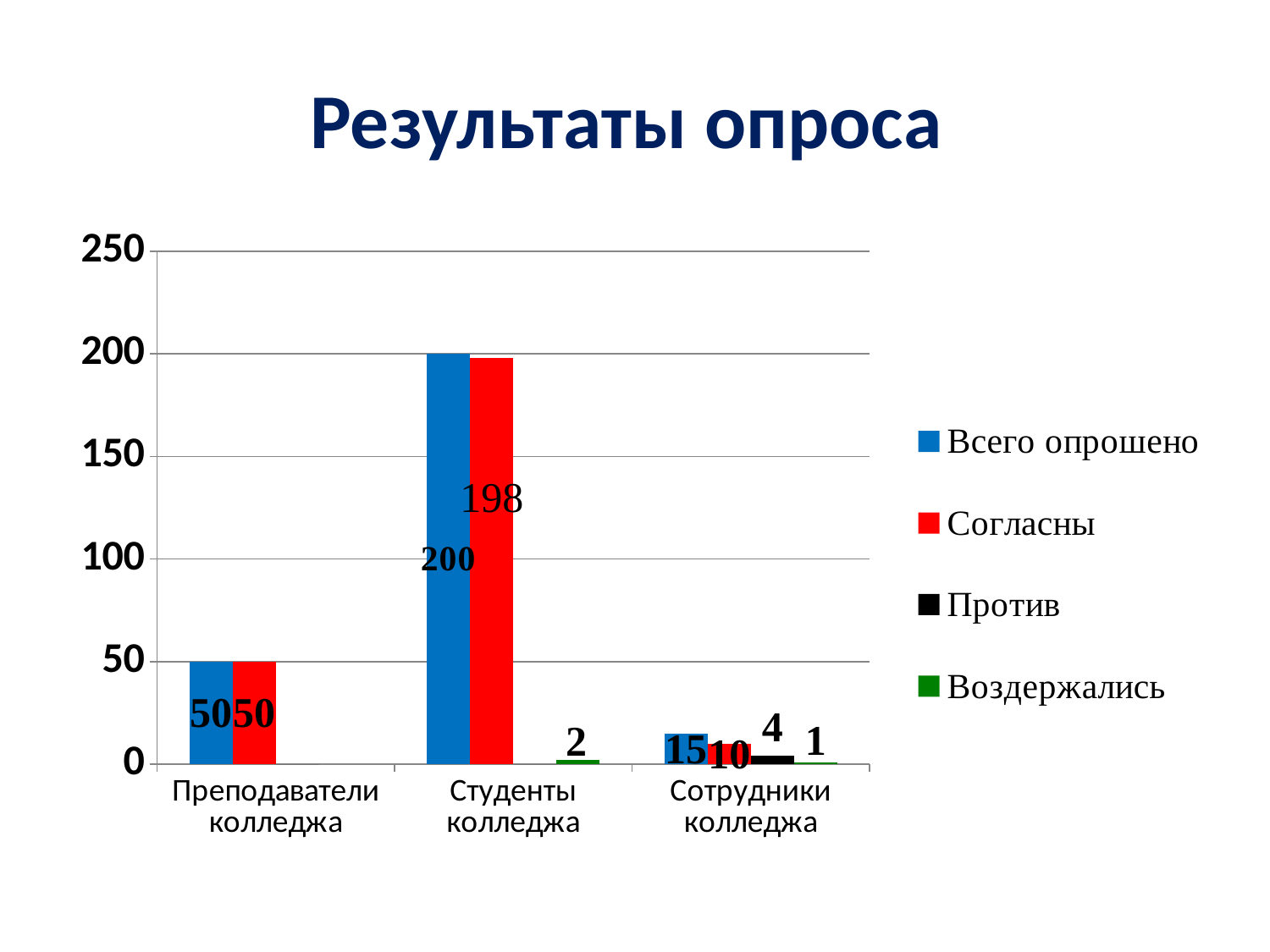
What is the value of Воздержались for Студенты колледжа? 2 Which is larger for Студенты колледжа: Всего опрошено or Согласны? Всего опрошено How many categories are shown on the x axis? 3 What kind of chart is shown on the slide? Bar chart Which category has the lowest value for Согласны? Сотрудники колледжа What is the difference between Всего опрошено and Согласны for Сотрудники колледжа? 5 Which category has the highest value for Всего опрошено? Студенты колледжа What is the title of the slide? Результаты опроса What is the value of Согласны for Студенты колледжа? 198 What is the value of Против for Сотрудники колледжа? 4 What is the value of Всего опрошено for Студенты колледжа? 200 How many series does the legend list? 4